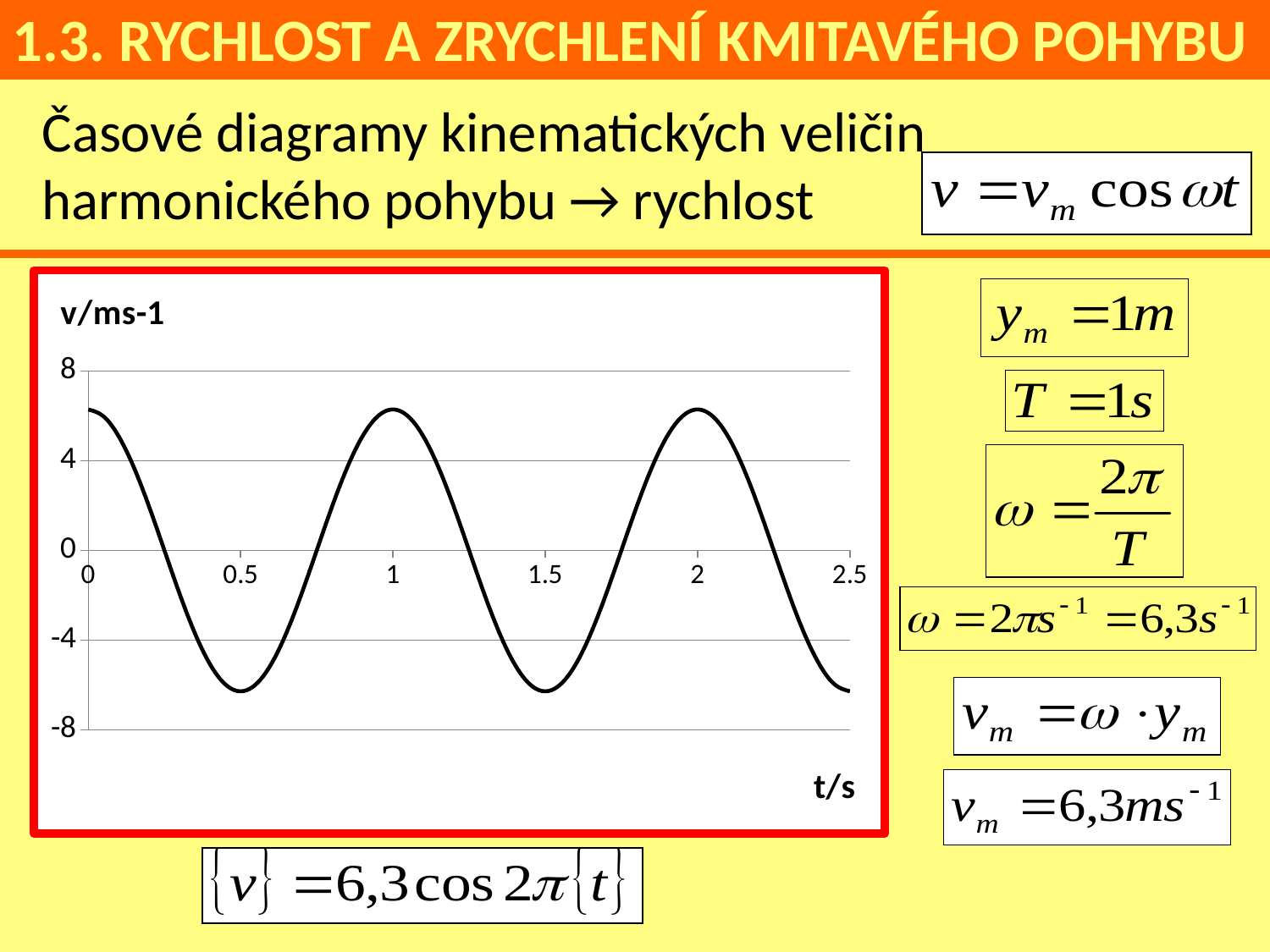
Is the value of v at t = 1 greater or less than 4? greater Which is larger, the value of v at t = 0 or at t = 0.5? t = 0 Is the value of v at t = 0 greater or less than 4? greater Is the value of v at t = 0.5 greater or less than -4? less Between t = 0 and t = 0.5, do the values of v rise or fall? fall Between t = 0.5 and t = 1, do the values of v rise or fall? rise How many tick labels are shown on the horizontal axis of the chart? 6 What is the label of the vertical axis of the chart? v/ms-1 What kind of chart is shown on the slide? line chart What is the label of the horizontal axis of the chart? t/s